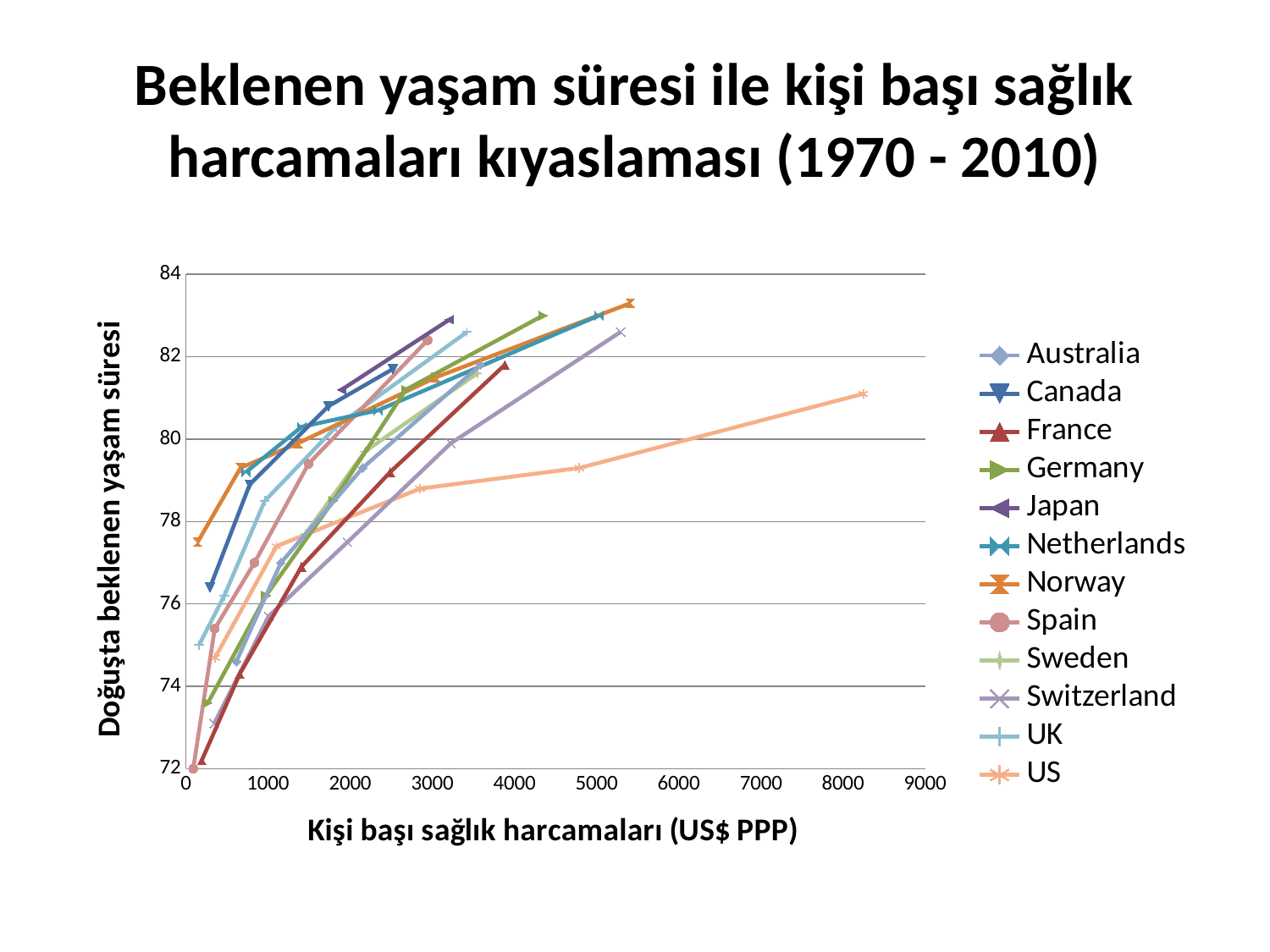
Which series reaches the highest health spending per capita on the x axis? US At their respective highest spending points, which has the higher life expectancy: the US or Japan? Japan Is the highest health spending value for Japan greater or less than 4000? less What is the x-axis title of the chart? Kişi başı sağlık harcamaları (US$ PPP) Is the highest life expectancy reached by Japan greater or less than 82? greater What kind of chart is shown on the slide? line chart What is the title of the chart? Beklenen yaşam süresi ile kişi başı sağlık harcamaları kıyaslaması (1970 - 2010) Is the life expectancy at the US series' highest spending point greater or less than 82? less How many series does the legend list? 12 For the US series, does life expectancy rise or fall as health spending increases along the x axis? rise